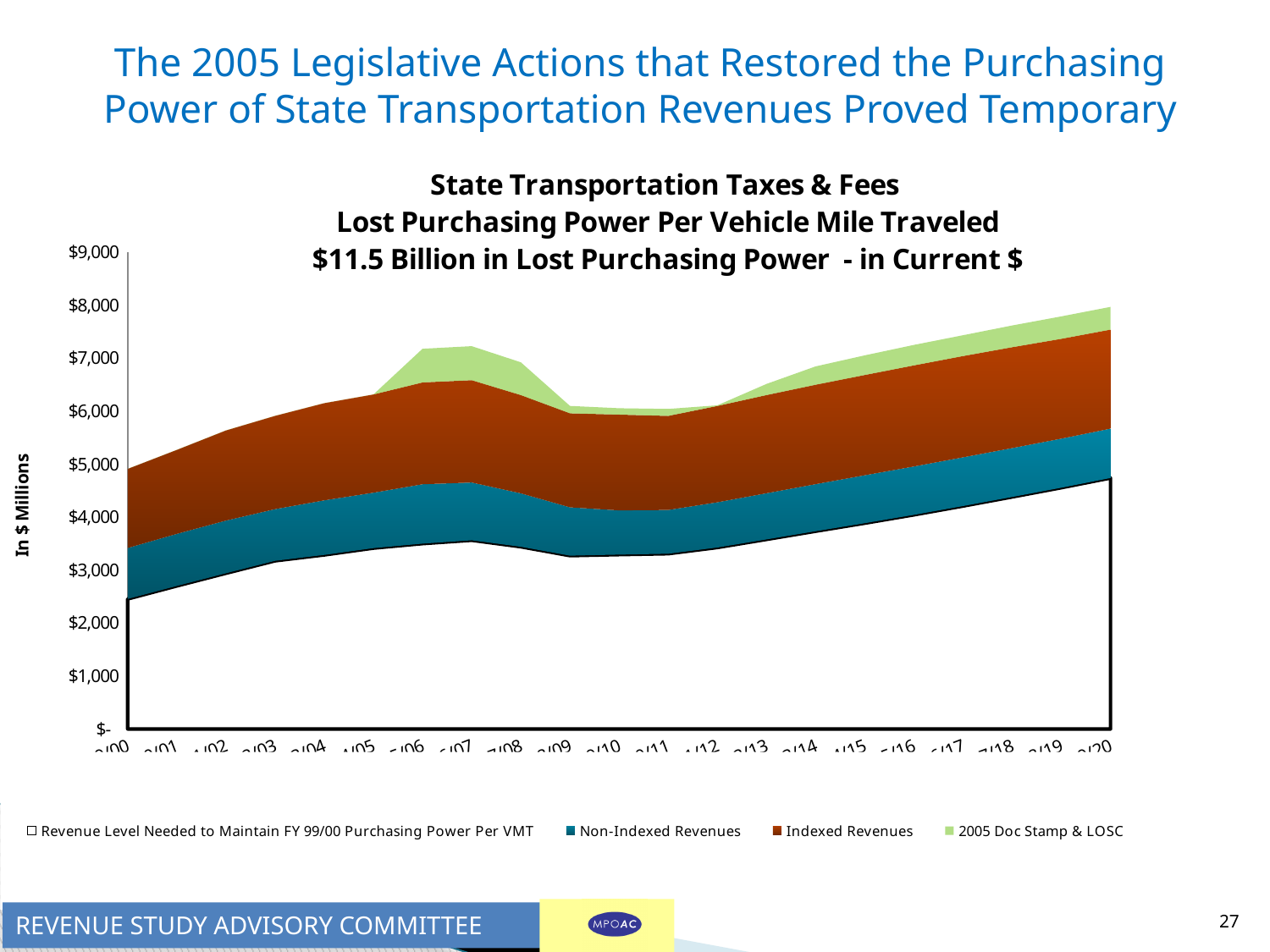
What is the label on the vertical axis of the chart? In $ Millions According to the chart title, how much purchasing power was lost in current dollars? $11.5 Billion Is the 'Revenue Level Needed to Maintain FY 99/00 Purchasing Power Per VMT' line at the rightmost point greater or less than $4,000? greater Is the 'Revenue Level Needed to Maintain FY 99/00 Purchasing Power Per VMT' line at the leftmost point greater or less than $3,000? less Is the top of the stacked area at the rightmost point on the x axis greater or less than $7,000? greater Does the 'Revenue Level Needed to Maintain FY 99/00 Purchasing Power Per VMT' line generally rise or fall from left to right along the x axis? rise What kind of chart is shown on the slide? Stacked area chart What is the highest value shown on the vertical axis of the chart? $9,000 How many series does the chart's legend list? 4